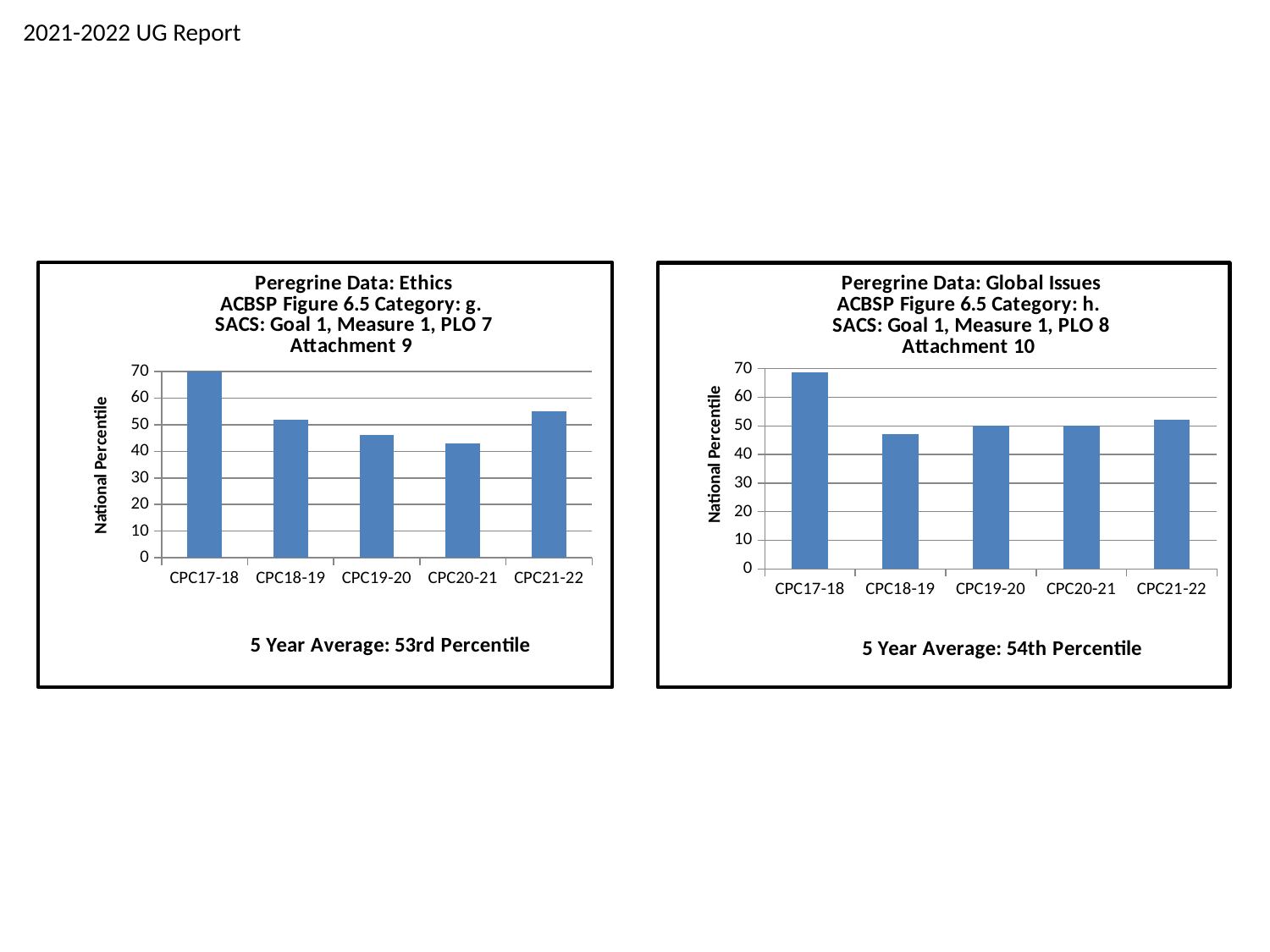
What kind of chart is the Peregrine Data: Global Issues chart? Bar chart In the Peregrine Data: Global Issues chart, which year has the lowest national percentile? CPC18-19 In the Peregrine Data: Ethics chart, is the value for CPC21-22 greater or less than 50? greater What is the 5 year average stated below the Peregrine Data: Global Issues chart? 54th Percentile In the Peregrine Data: Ethics chart, is the value for CPC20-21 greater or less than 50? less In the Peregrine Data: Global Issues chart, which year has the highest national percentile? CPC17-18 In the Peregrine Data: Ethics chart, which year has the highest national percentile? CPC17-18 How many years are plotted in the Peregrine Data: Ethics chart? 5 In the Peregrine Data: Global Issues chart, is the value for CPC17-18 greater or less than 60? greater In the Peregrine Data: Ethics chart, which year has the lowest national percentile? CPC20-21 In the Peregrine Data: Ethics chart, which is larger, the value for CPC18-19 or CPC19-20? CPC18-19 What is the y-axis label of the Peregrine Data: Ethics chart? National Percentile